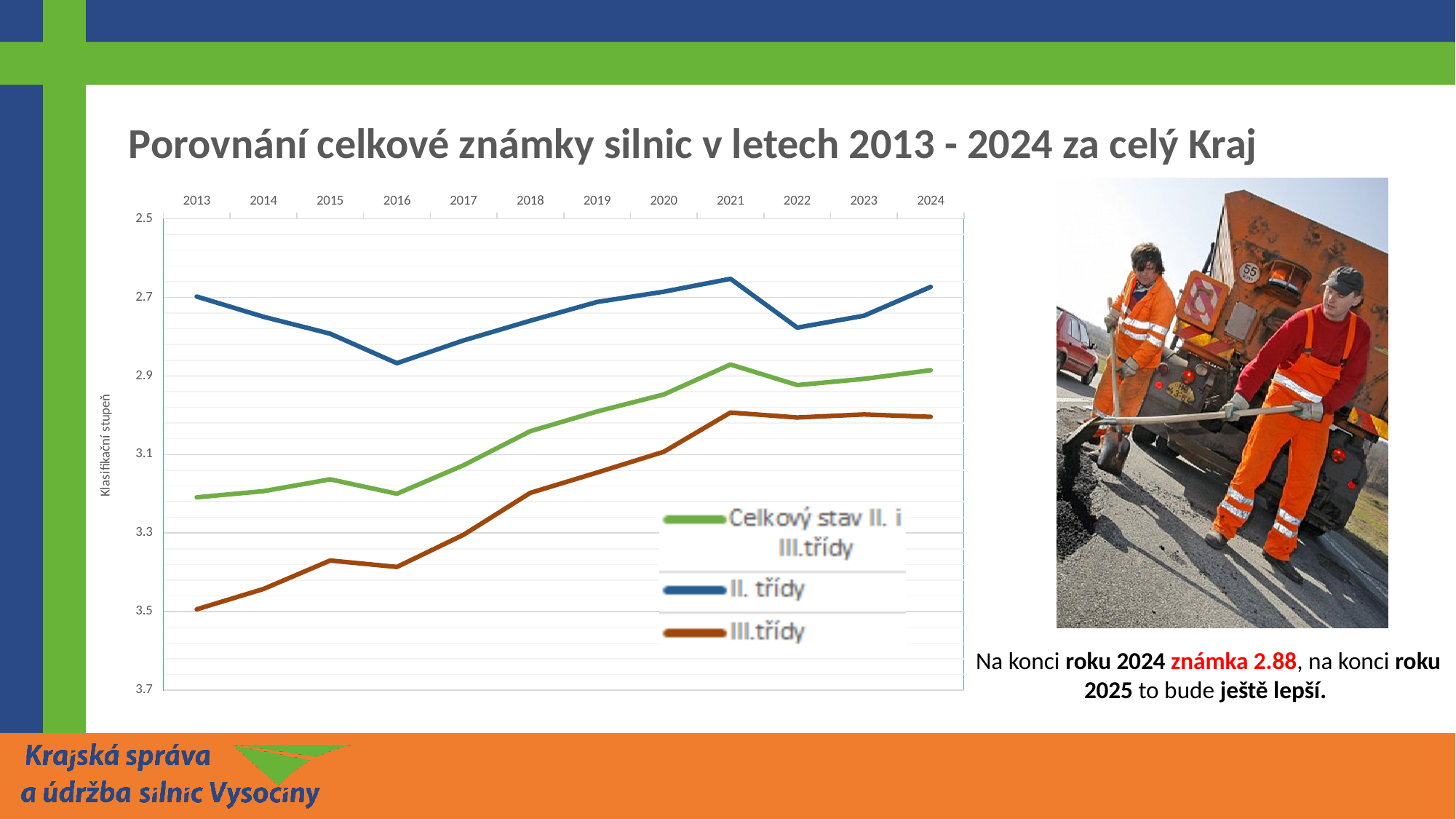
Do the values for III.třídy rise or fall from 2013 to 2024? fall What kind of chart is shown on the slide? line chart In which year does the III.třídy series reach its highest value? 2013 What is the title of the chart on the slide? Porovnání celkové známky silnic v letech 2013 - 2024 za celý Kraj In 2013, which series has the larger value: II. třídy or III.třídy? III.třídy How many years are plotted along the x axis of the chart? 12 Is the value for III.třídy in 2024 greater or less than 3.1? less Is the value for Celkový stav II. i III.třídy in 2013 greater or less than 3.1? greater Is the value for III.třídy in 2013 greater or less than 3.3? greater How many series does the chart legend list? 3 What is the label of the vertical axis of the chart? Klasifikační stupeň